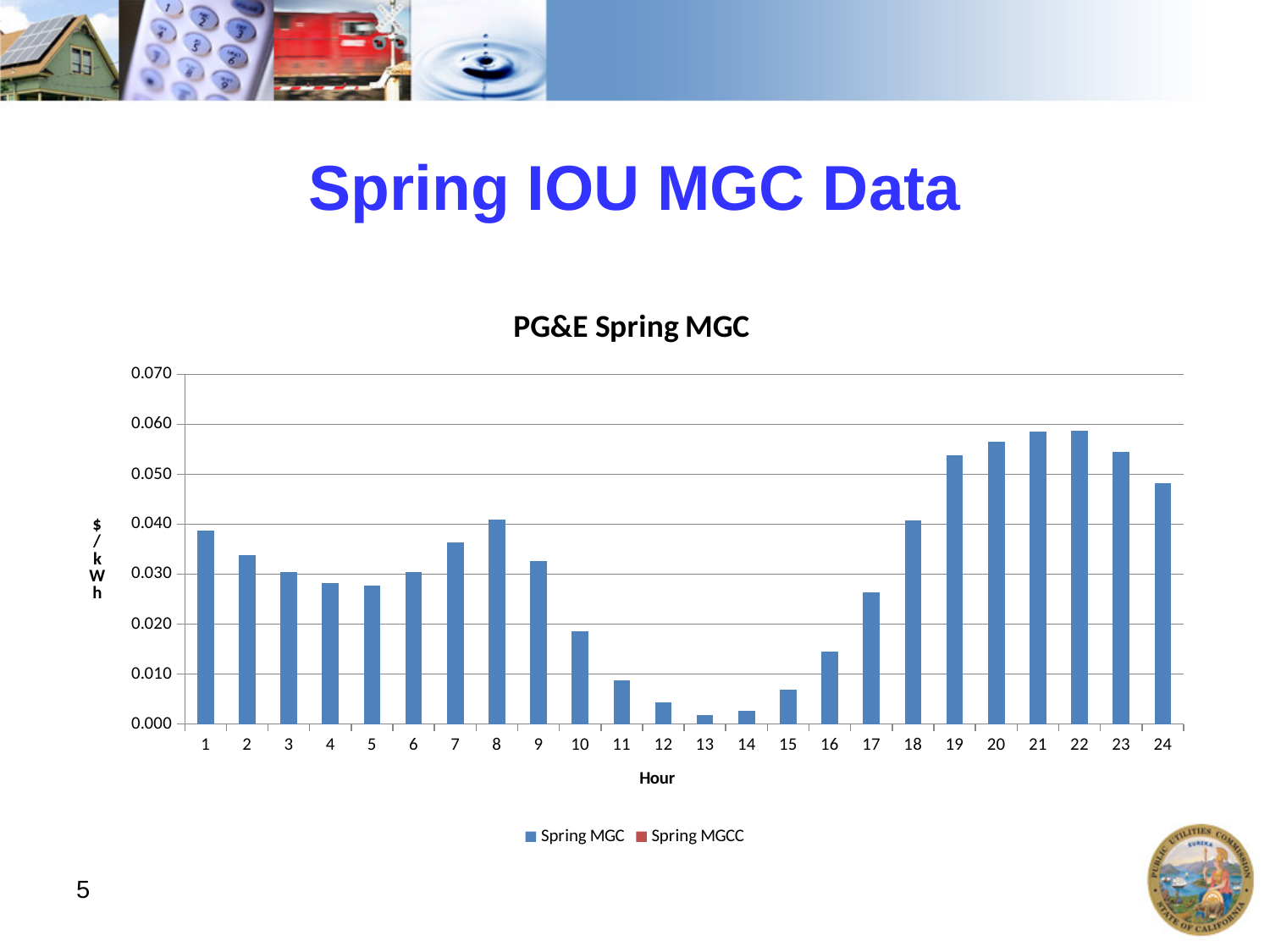
Which hour has the larger Spring MGC value, hour 11 or hour 16? hour 16 What kind of chart is shown on the slide? bar chart Is the Spring MGC value for hour 21 greater or less than 0.050? greater Is the Spring MGC value for hour 13 greater or less than 0.010? less What is the title of the chart? PG&E Spring MGC Which hour has the lowest Spring MGC value? 13 How many hours are shown on the x axis? 24 Do the Spring MGC values rise or fall from hour 8 to hour 13? fall How many series does the legend list? 2 Which hour has the larger Spring MGC value, hour 1 or hour 2? hour 1 Is the Spring MGC value for hour 17 greater or less than 0.030? less